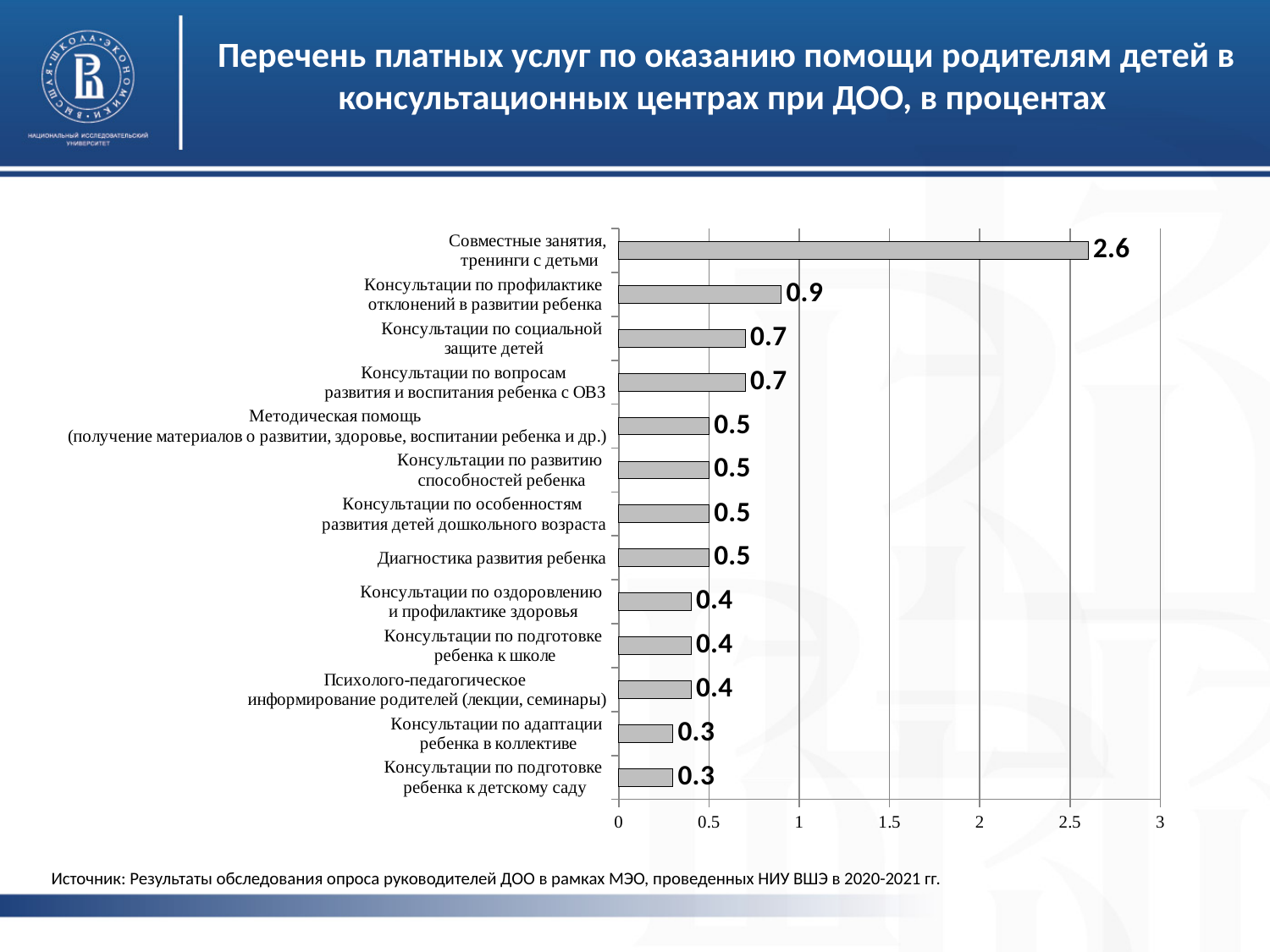
Is the value for «Совместные занятия, тренинги с детьми» greater or less than 2.5? greater Which is larger: the value for «Консультации по социальной защите детей» or the value for «Консультации по подготовке ребенка к школе»? Консультации по социальной защите детей Which category has the highest value? Совместные занятия, тренинги с детьми What is the value for «Консультации по вопросам развития и воспитания ребенка с ОВЗ»? 0.7 What kind of chart is shown on the slide? bar chart What is the value for «Диагностика развития ребенка»? 0.5 What is the difference between the values for «Совместные занятия, тренинги с детьми» and «Консультации по профилактике отклонений в развитии ребенка»? 1.7 What is the value for «Совместные занятия, тренинги с детьми»? 2.6 What is the maximum value shown on the horizontal axis of the chart? 3 What is the value for «Консультации по подготовке ребенка к детскому саду»? 0.3 How many categories are shown in the chart? 13 What is the value for «Консультации по профилактике отклонений в развитии ребенка»? 0.9